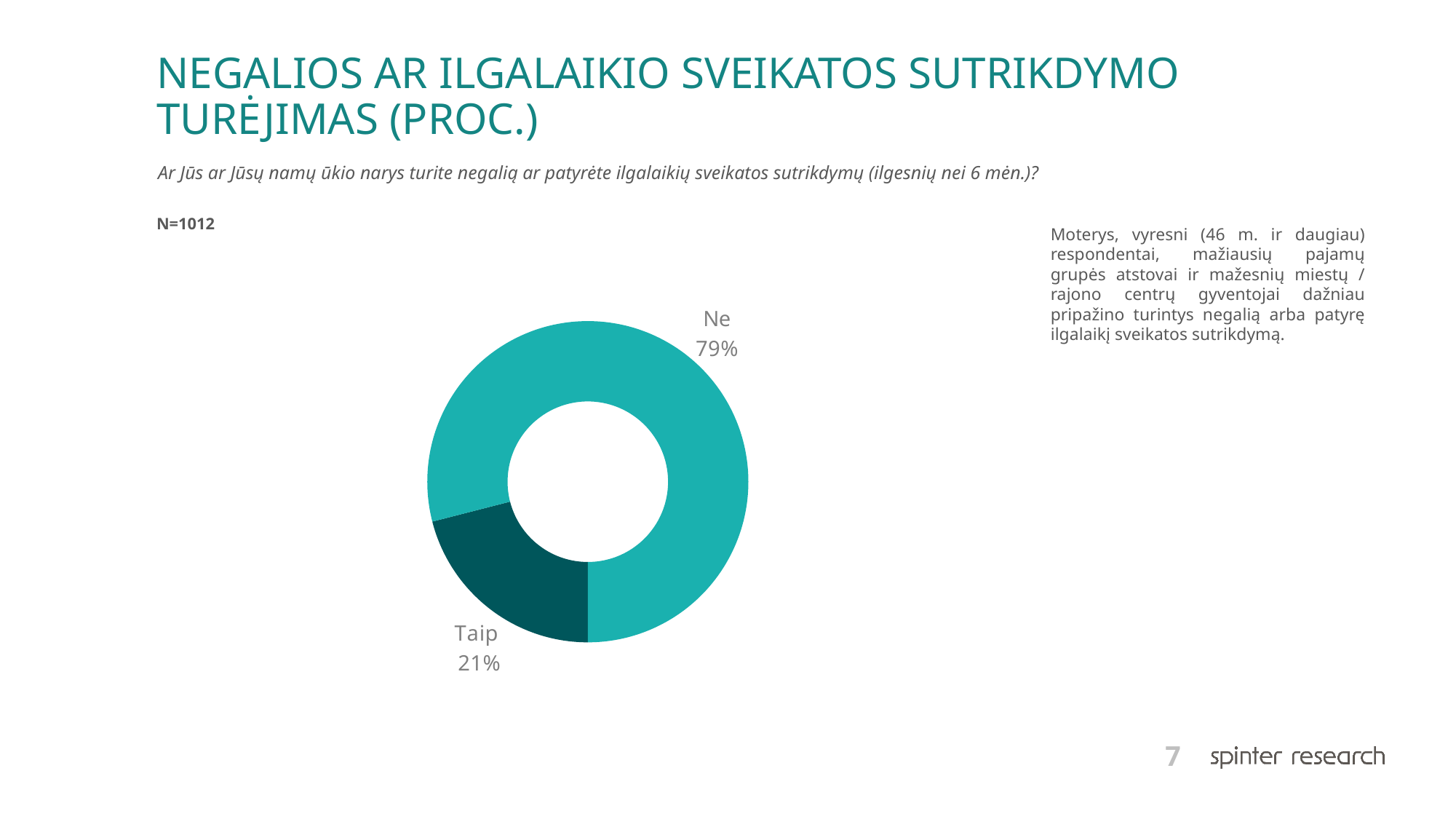
What percentage of respondents answered "Taip"? 21% What share of the pie does the "Taip" slice represent? 21% What percentage of respondents answered "Ne"? 79% Which answer has the largest share of the chart? Ne What is the sample size (N) stated on the slide? N=1012 What is the difference in percentage points between the "Ne" and "Taip" shares? 58 What kind of chart is shown on the slide? Pie chart (doughnut) Which answer has the smallest share of the chart? Taip Which slice is drawn in the darker teal colour? Taip How many categories are shown in the chart? 2 Which is larger, the share for "Ne" or the share for "Taip"? Ne